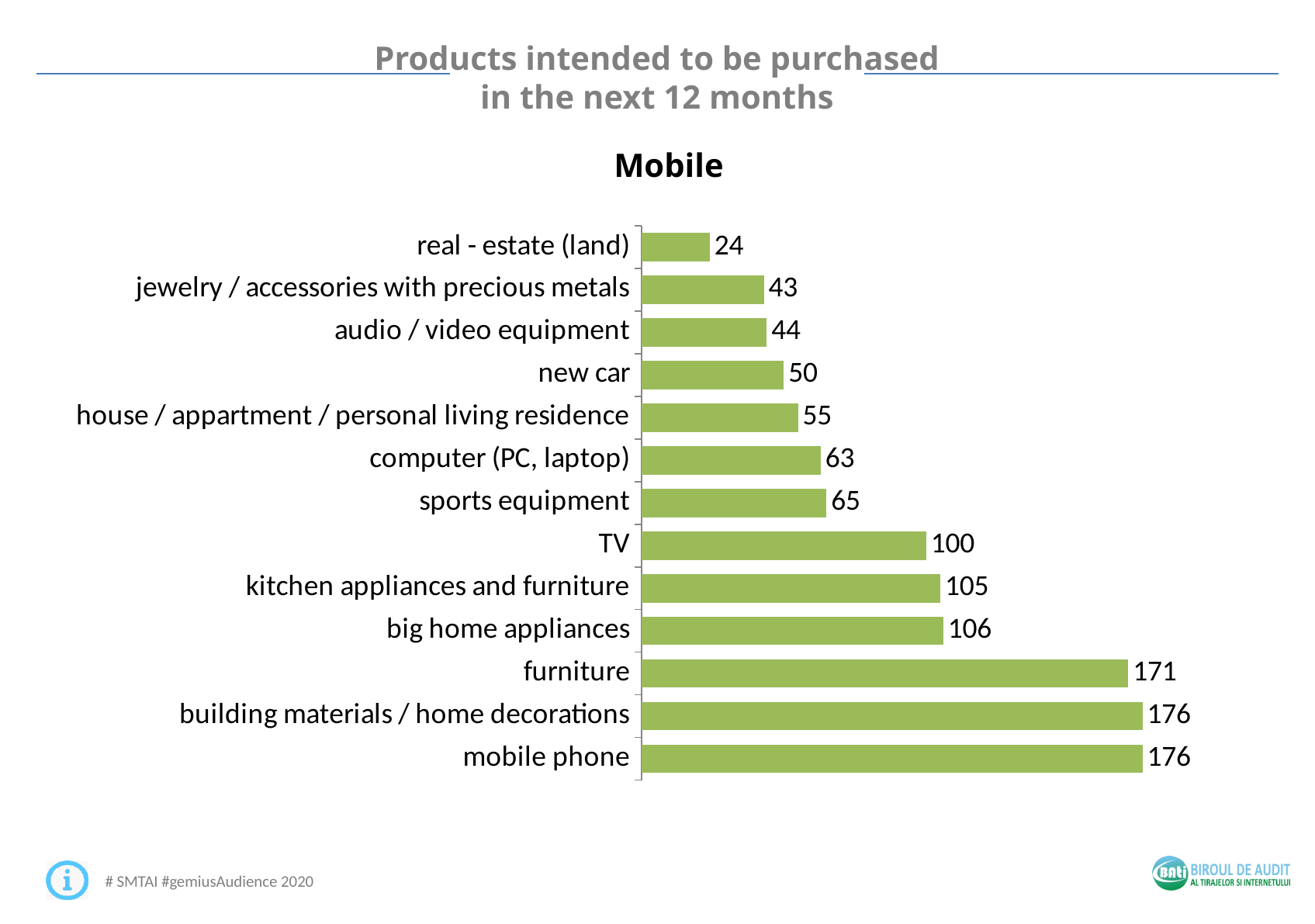
What is the value for furniture? 171 Which is larger, the value for big home appliances or the value for audio / video equipment? big home appliances How many categories are shown in the chart? 13 Which category has the lowest value? real - estate (land) What is the difference between the values for TV and sports equipment? 35 What is the title of the chart? Mobile What is the value for computer (PC, laptop)? 63 What is the difference between the values for mobile phone and furniture? 5 What kind of chart is shown on the slide? bar chart What is the value for TV? 100 What is the value for new car? 50 Which is larger, the value for jewelry / accessories with precious metals or the value for house / appartment / personal living residence? house / appartment / personal living residence